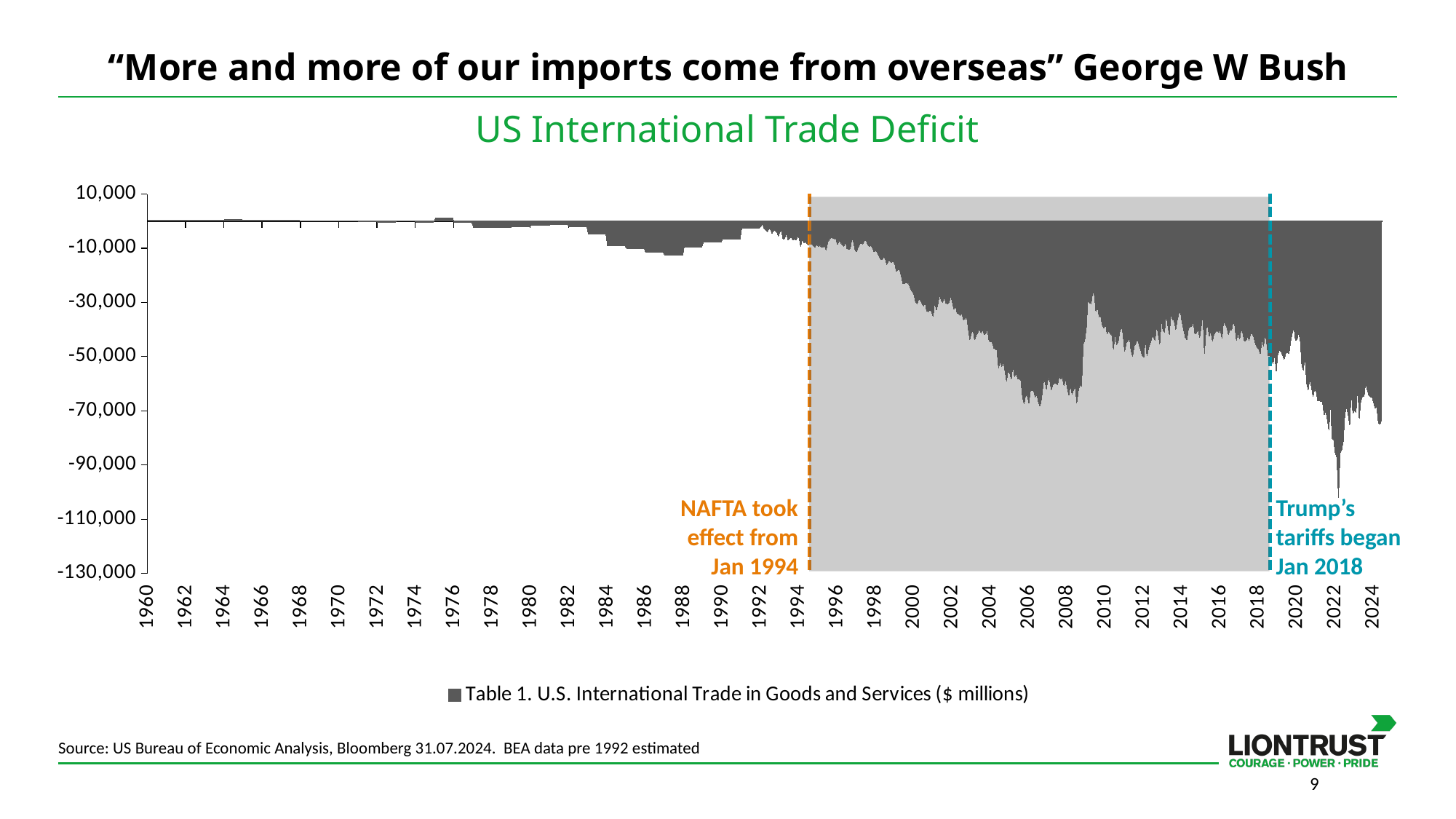
Is the lowest value around 2022 greater or less than -70,000? less What is the title of the chart? US International Trade Deficit Around which year does the series reach its lowest point? 2022 Is the value for 2006 greater or less than -50,000? less How many year labels are shown on the x axis? 33 Is the value for 1980 greater or less than -10,000? greater Overall, do the values rise or fall from 1960 to 2024? Fall How many series does the legend list? 1 Which is lower, the value around 2006 or the value around 2010? 2006 According to the annotation, when did Trump's tariffs begin? Jan 2018 What kind of chart is shown on the slide? Area chart